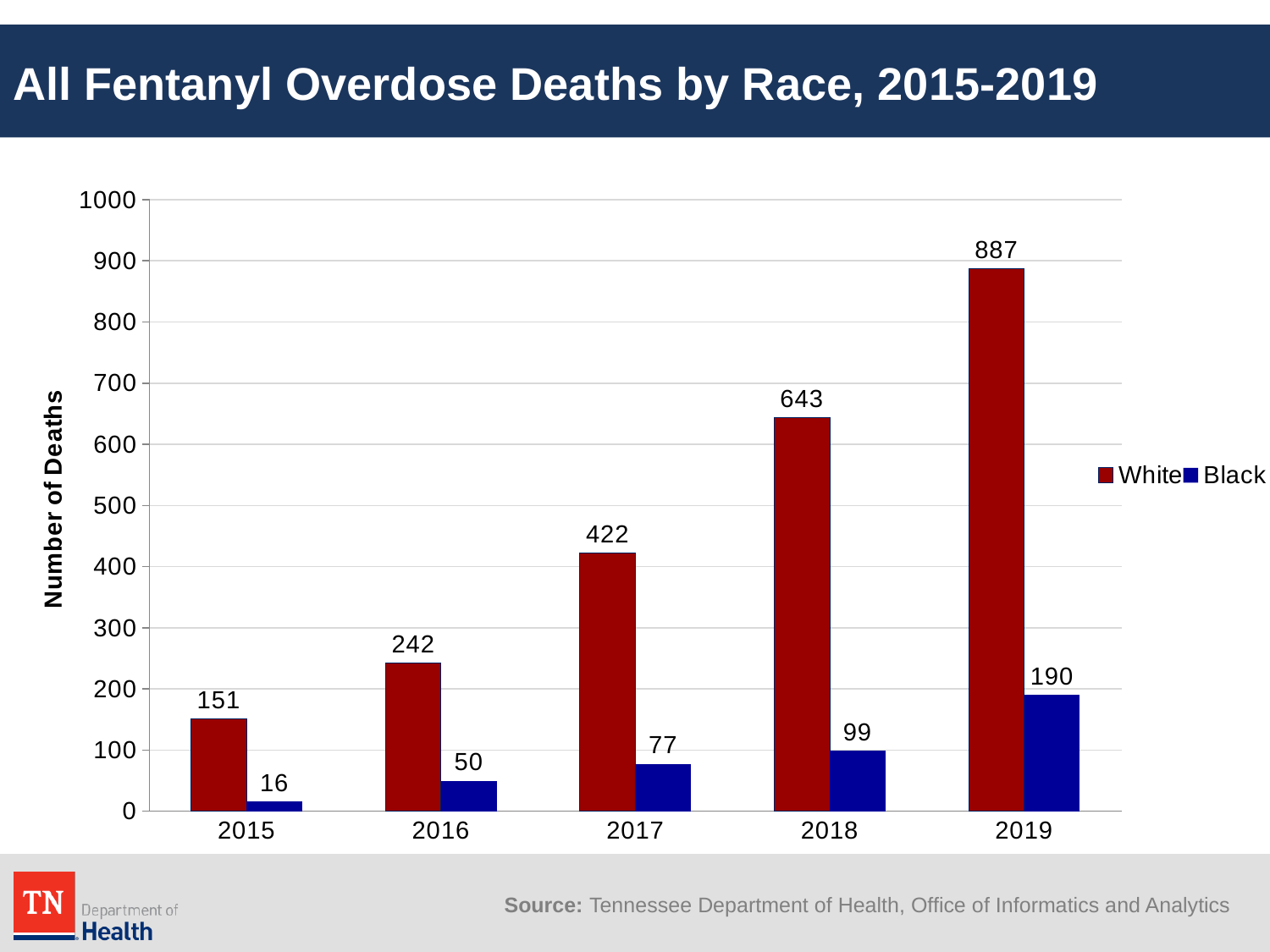
Do the White deaths rise or fall from 2015 to 2019? Rise How many years are shown on the x axis? 5 What is the number of fentanyl overdose deaths for Black in 2015? 16 Which year has the lowest number of deaths for Black? 2015 What is the value for Black in 2017? 77 What is the difference between White and Black deaths in 2018? 544 What is the title of the chart? All Fentanyl Overdose Deaths by Race, 2015-2019 How many series does the legend list? 2 Which is larger, the White value in 2016 or the Black value in 2019? White in 2016 Which year has the highest number of deaths for White? 2019 What is the number of fentanyl overdose deaths for White in 2019? 887 What kind of chart is shown on the slide? Bar chart